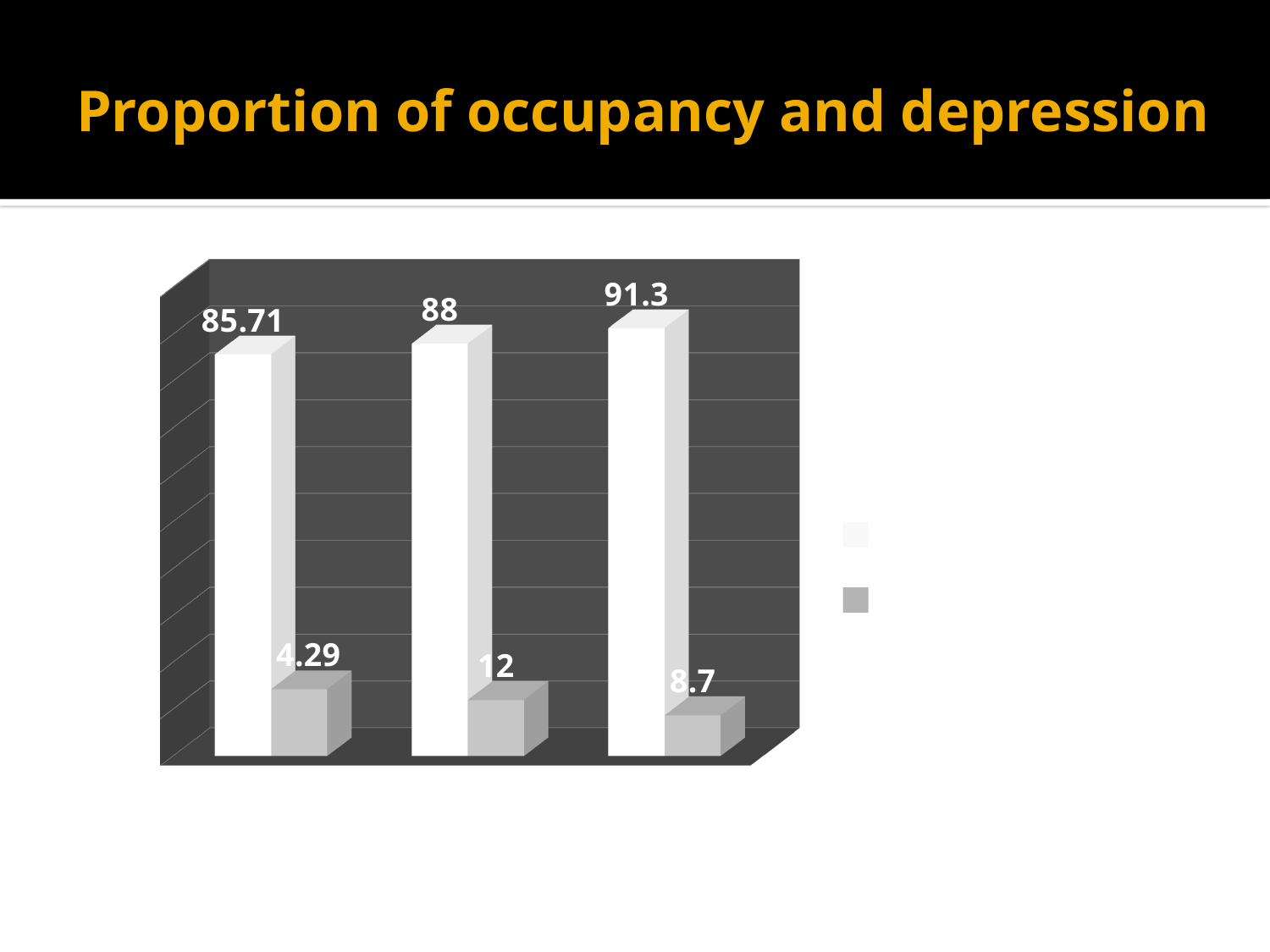
What is the difference between the white bar values of the rightmost and leftmost groups? 5.59 How many series does the legend list? 2 Which group has the highest white bar value? The rightmost group (91.3) Which group has the lowest grey bar value? The rightmost group (8.7) Which is larger: the grey bar in the middle group or the grey bar in the rightmost group? The middle group (12) What type of chart is shown on the slide? Bar chart What is the value of the white bar in the leftmost group? 85.71 How many groups of bars are plotted in the chart? 3 What is the value of the white bar in the rightmost group? 91.3 What is the value of the grey bar in the middle group? 12 Do the white bar values rise or fall from left to right across the groups? Rise What is the title of the chart? Proportion of occupancy and depression